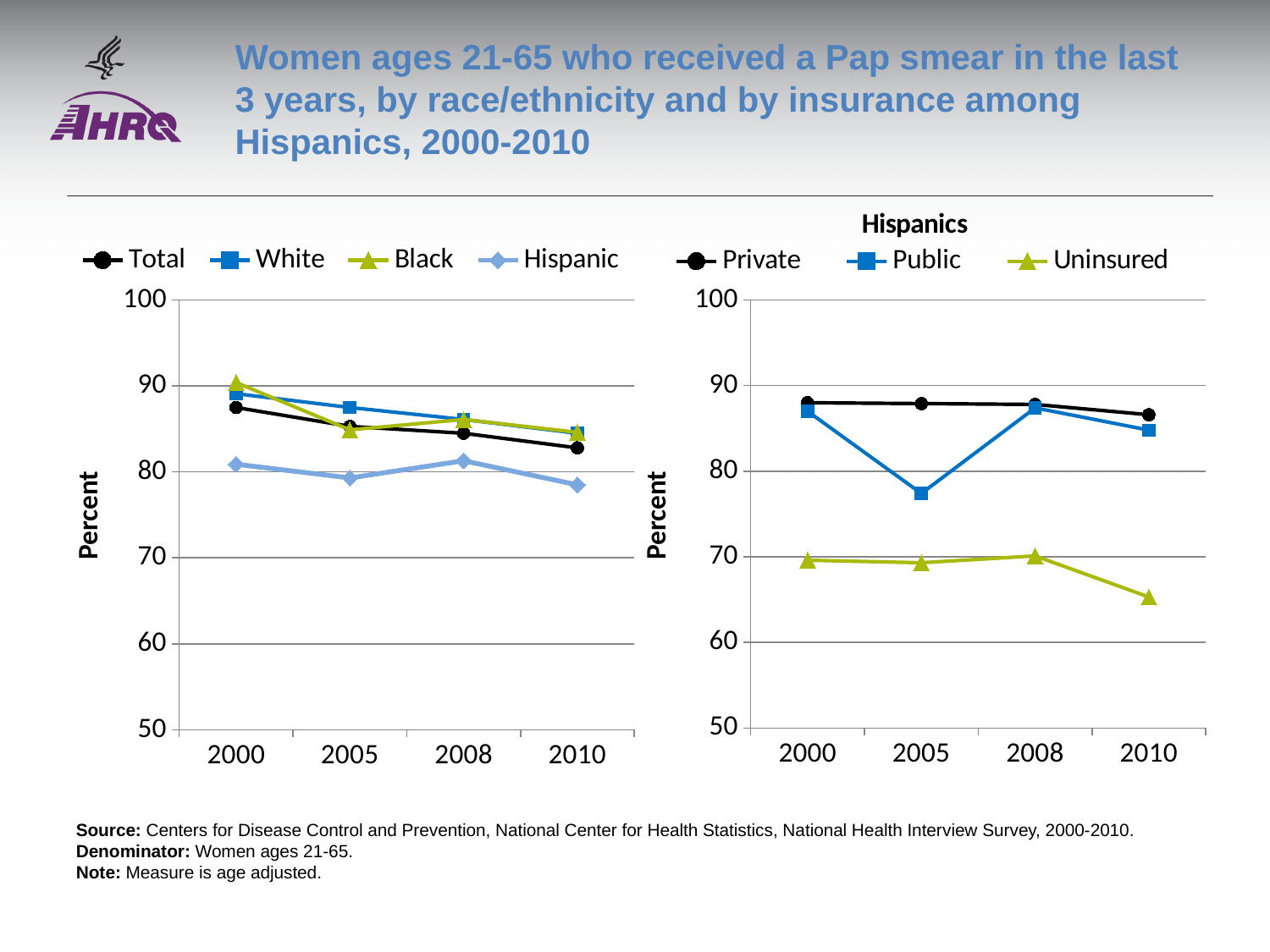
How many series does the legend of the left chart list? 4 In the right chart (Hispanics), is the value for Public in 2005 greater or less than 80? less In the left chart, is the value for Hispanic in 2010 greater or less than 80? less How many series does the legend of the right chart (Hispanics) list? 3 How many years are plotted along the x axis of the right chart (Hispanics)? 4 In the left chart, which series has the lowest value in 2010? Hispanic What kind of chart is the left chart on the slide? line chart In the left chart, does the Total series rise or fall from 2000 to 2010? fall In the right chart (Hispanics), which is larger in 2005, Private or Public? Private In the right chart (Hispanics), which series has the lowest value in 2005? Uninsured In the left chart, which series has the highest value in 2000? Black